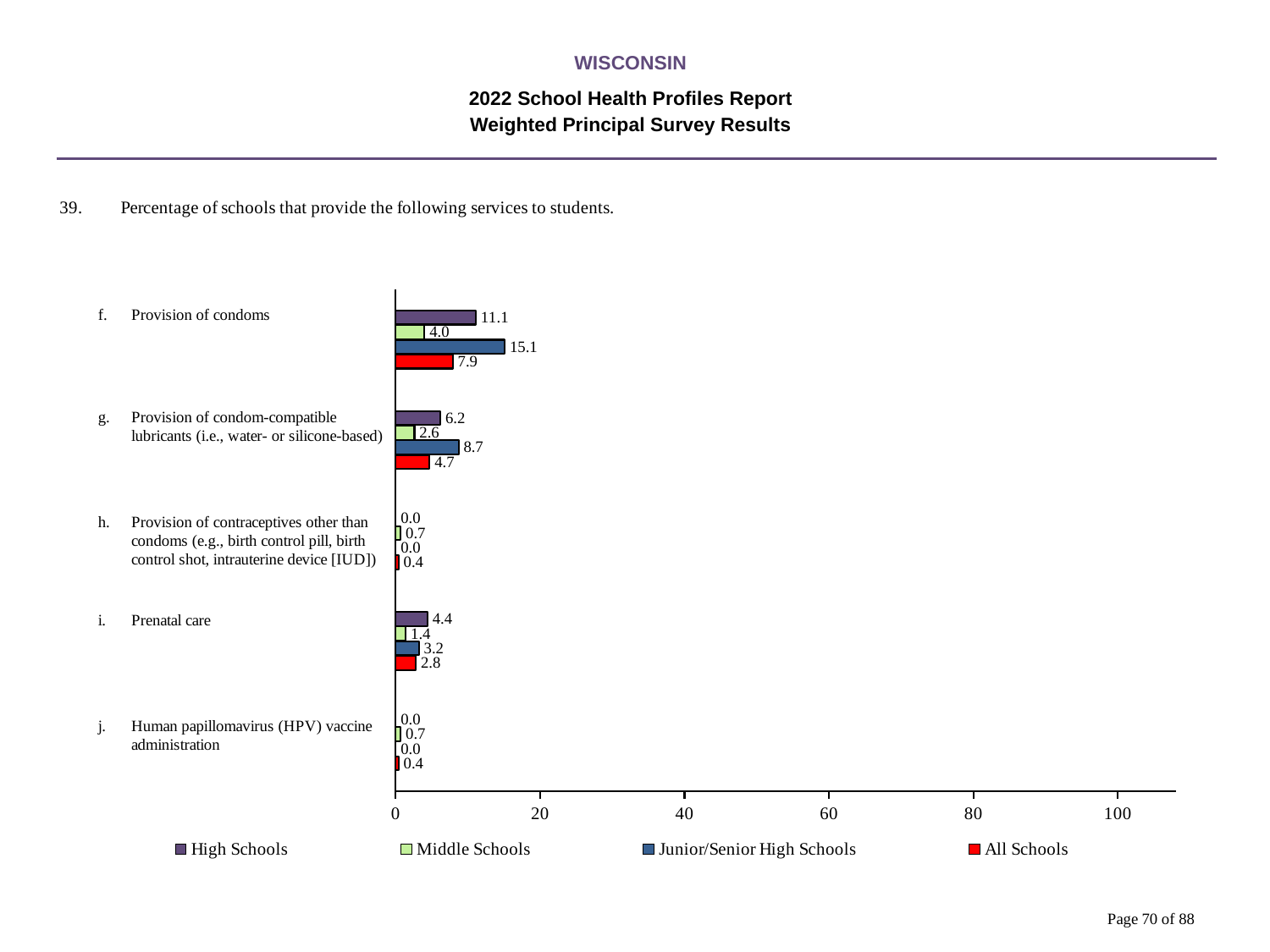
What is the value for All Schools for provision of condom-compatible lubricants? 4.7 Which service has the lowest value for High Schools, provision of condoms or prenatal care? Prenatal care Which school type has the highest value for provision of condoms? Junior/Senior High Schools How many series does the legend list? 4 Which is larger for prenatal care: the High Schools value or the Junior/Senior High Schools value? High Schools What is the difference between the High Schools and Middle Schools values for provision of condoms? 7.1 What is the value for Middle Schools for prenatal care? 1.4 What colour represents All Schools in the legend? Red Is the Junior/Senior High Schools value for provision of condoms greater or less than 20? less What percentage of Junior/Senior High Schools provide condoms? 15.1 How many services are listed on the chart? 5 What kind of chart is shown on the slide? Bar chart